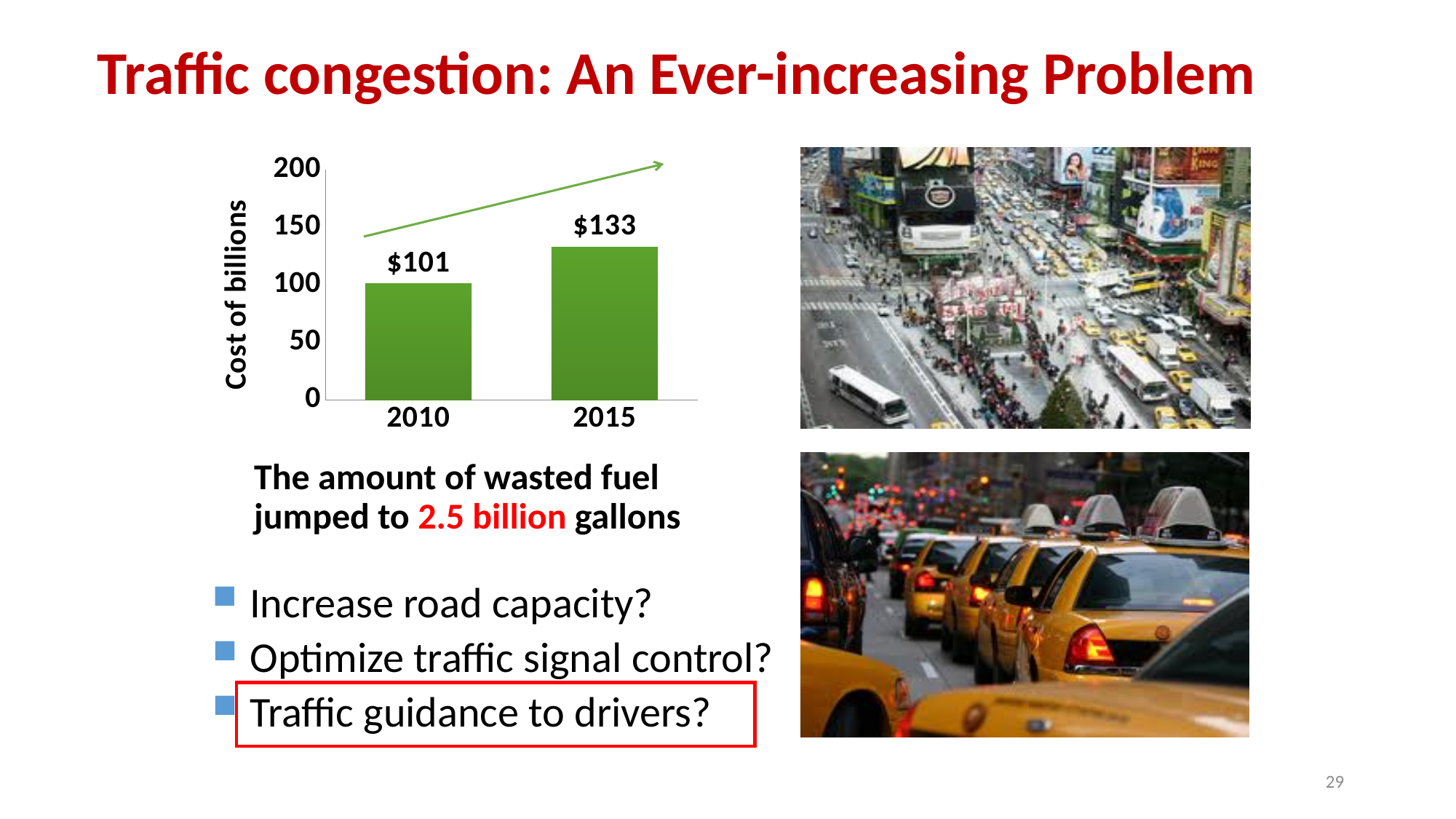
Which year has the lower cost in the bar chart? 2010 What is the difference between the 2015 and 2010 values in the bar chart? $32 What is the value for 2010 in the bar chart? $101 Is the value for 2010 greater or less than 50? greater How many bars are shown in the chart? 2 What is the value for 2015 in the bar chart? $133 What kind of chart is shown on the slide? bar chart Which year has the higher cost in the bar chart? 2015 Do the values rise or fall from 2010 to 2015? rise Is the value for 2010 larger or smaller than the value for 2015? smaller Is the value for 2015 greater or less than 150? less What is the label on the vertical axis of the chart? Cost of billions